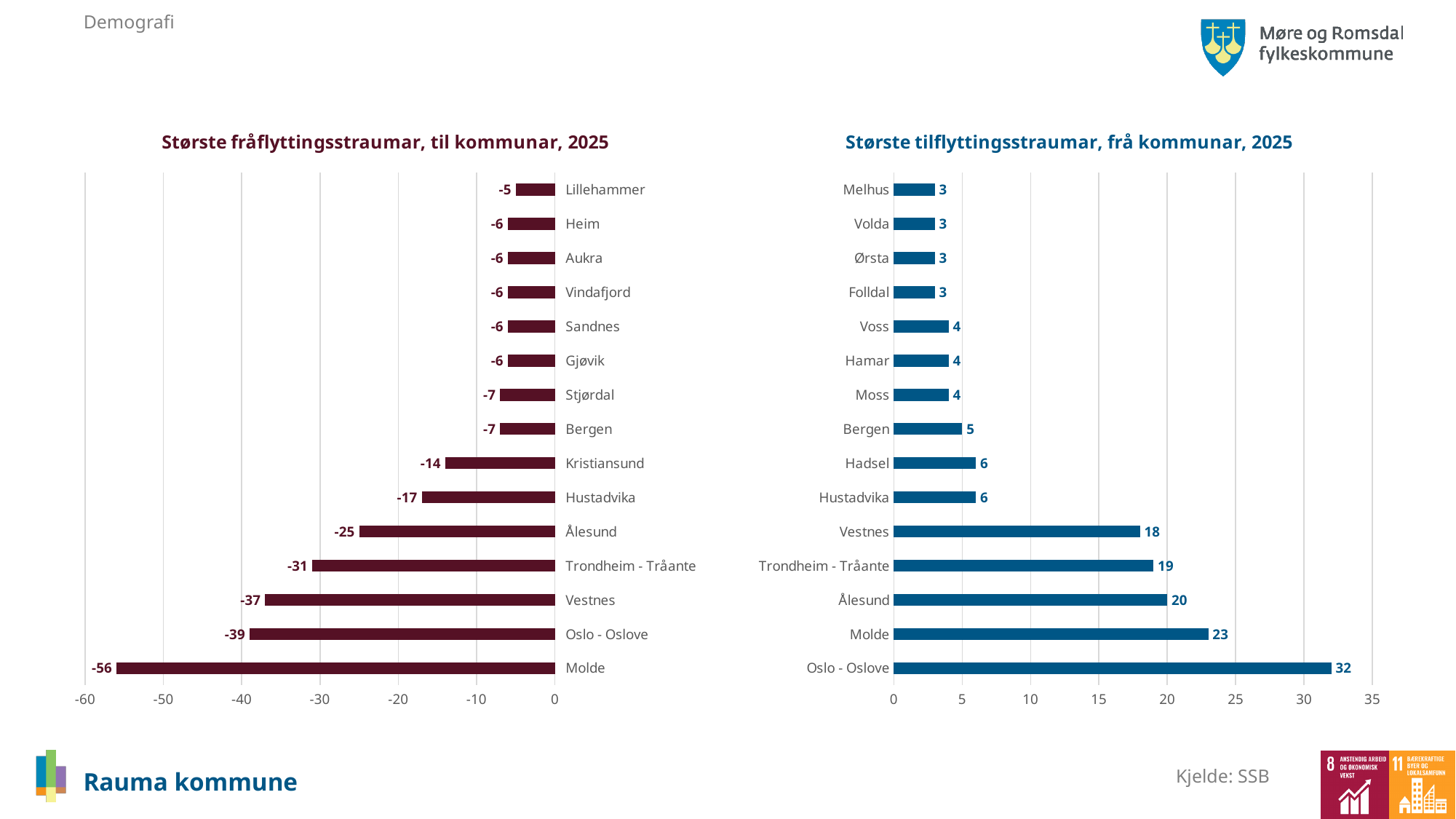
In the chart 'Største fråflyttingsstraumar, til kommunar, 2025', what is the value for Ålesund? -25 In the chart 'Største fråflyttingsstraumar, til kommunar, 2025', which municipality has the smallest bar (closest to zero)? Lillehammer In the chart 'Største fråflyttingsstraumar, til kommunar, 2025', what is the value for Molde? -56 How many municipalities are shown in the chart 'Største fråflyttingsstraumar, til kommunar, 2025'? 15 In the chart 'Største tilflyttingsstraumar, frå kommunar, 2025', what is the value for Oslo - Oslove? 32 In the chart 'Største tilflyttingsstraumar, frå kommunar, 2025', what is the value for Vestnes? 18 In the chart 'Største tilflyttingsstraumar, frå kommunar, 2025', which is larger, the value for Trondheim - Tråante or the value for Vestnes? Trondheim - Tråante In the chart 'Største tilflyttingsstraumar, frå kommunar, 2025', what is the difference between the values for Molde and Ålesund? 3 In the chart 'Største tilflyttingsstraumar, frå kommunar, 2025', which municipality has the highest value? Oslo - Oslove What kind of chart is 'Største tilflyttingsstraumar, frå kommunar, 2025'? Bar chart In the chart 'Største fråflyttingsstraumar, til kommunar, 2025', what is the difference between the values for Oslo - Oslove and Vestnes? 2 What is the source cited at the bottom of the slide? SSB